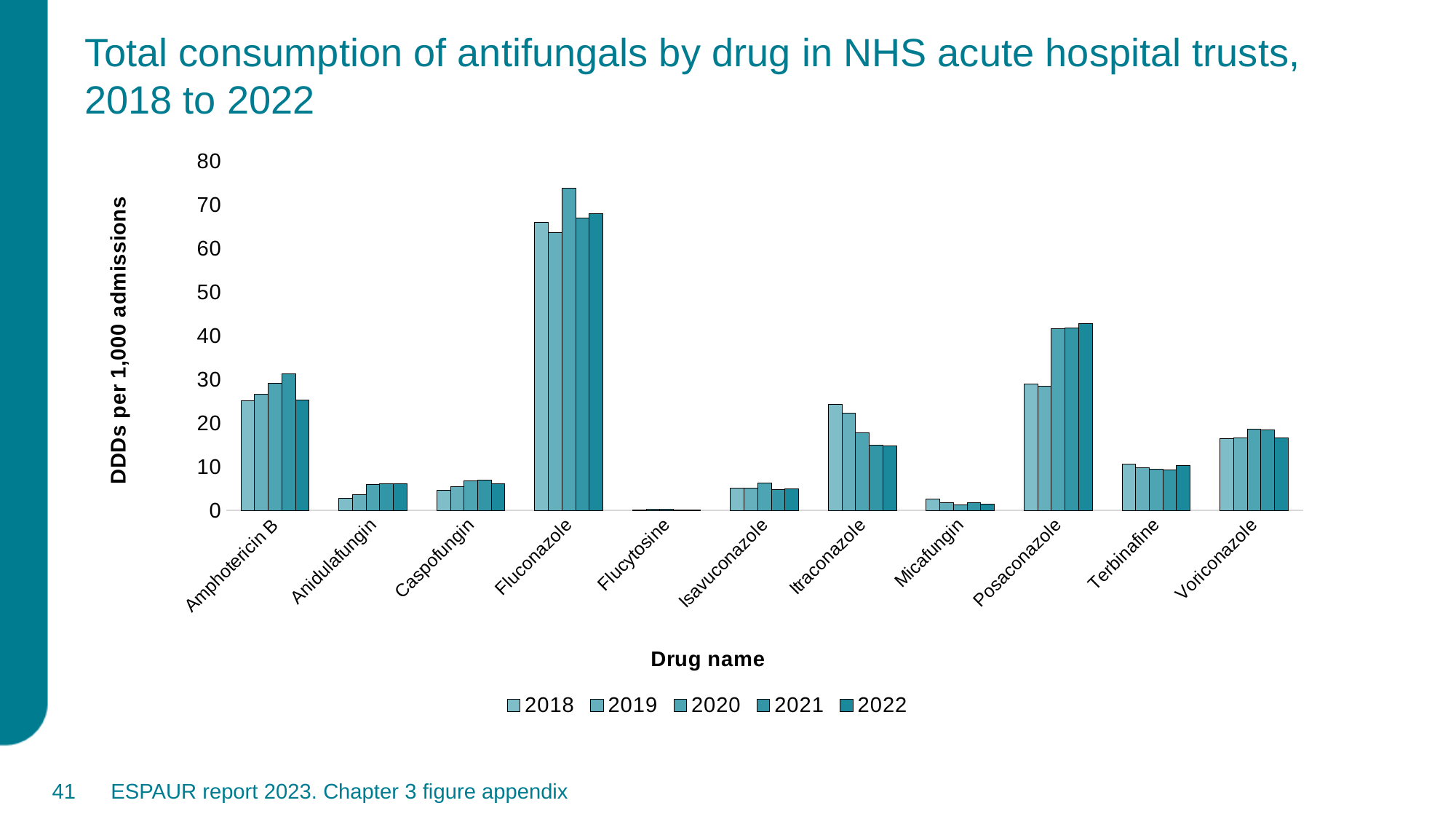
How many drug names are shown on the x axis? 11 Is the value for Fluconazole in 2020 greater or less than 70? greater Which is larger in 2021: the value for Amphotericin B or the value for Posaconazole? Posaconazole Which drug has the highest consumption in 2020? Fluconazole What is the label on the y axis? DDDs per 1,000 admissions How many series does the legend list? 5 Do the values for Itraconazole rise or fall from 2018 to 2022? fall Which drug has the lowest consumption across all years? Flucytosine What kind of chart is shown on the slide? bar chart Is the value for Itraconazole in 2018 greater or less than 20? greater Is the value for Posaconazole in 2022 greater or less than 40? greater